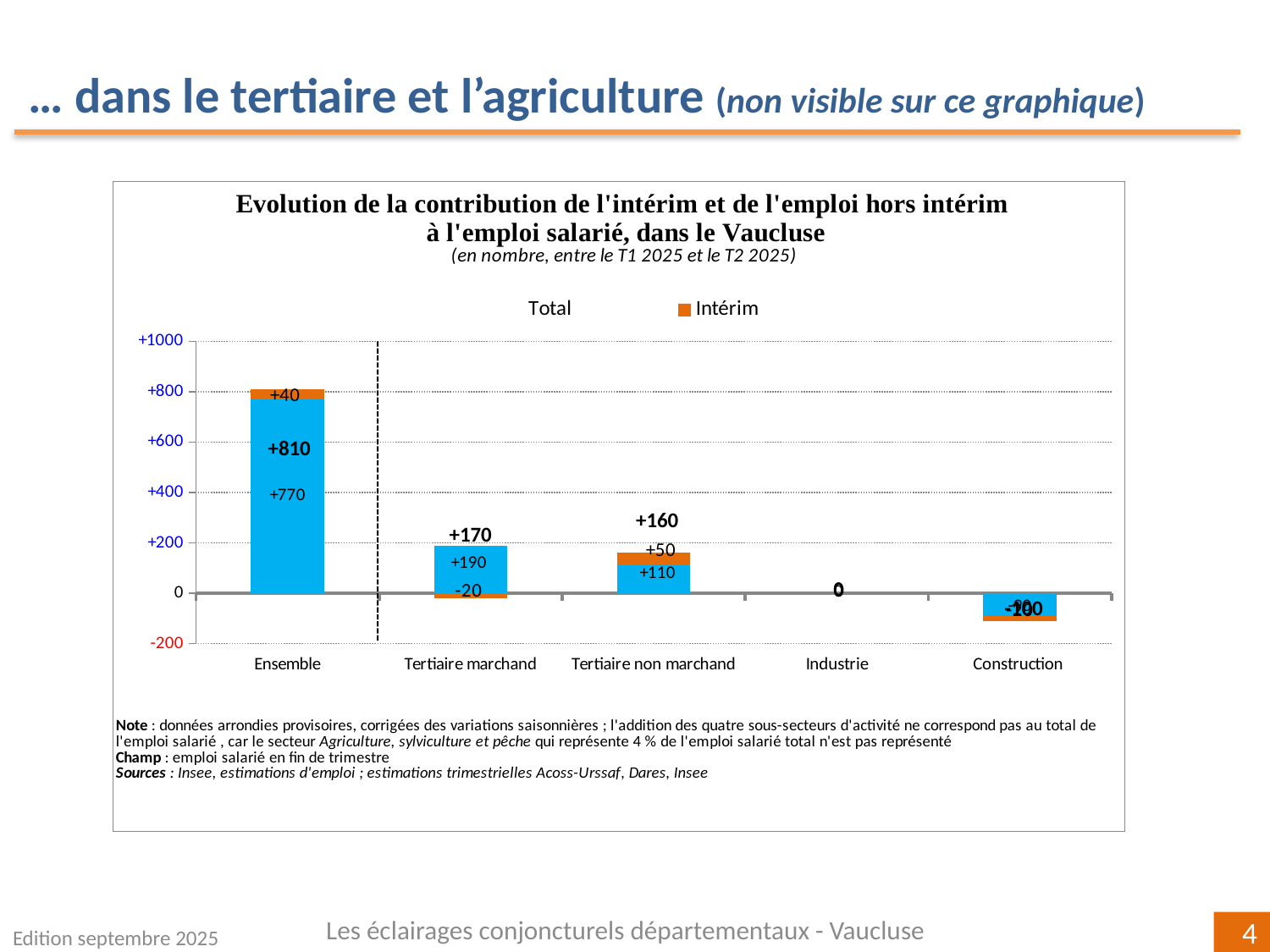
What is the blue (hors intérim) value shown for Tertiaire marchand? +190 What is the total value shown for Ensemble? +810 What is the difference between the total for Tertiaire marchand and the total for Tertiaire non marchand? 10 Is the Intérim value for Tertiaire non marchand larger or smaller than the Intérim value for Ensemble? larger How many categories are shown on the x axis? 5 Which category has the highest total value? Ensemble What is the Intérim value shown for Tertiaire marchand? -20 What is the Intérim value shown for Ensemble? +40 Is the value for Construction greater or less than 0? less What is the value shown for Industrie? 0 What is the Intérim value shown for Tertiaire non marchand? +50 What is the total value shown for Tertiaire non marchand? +160